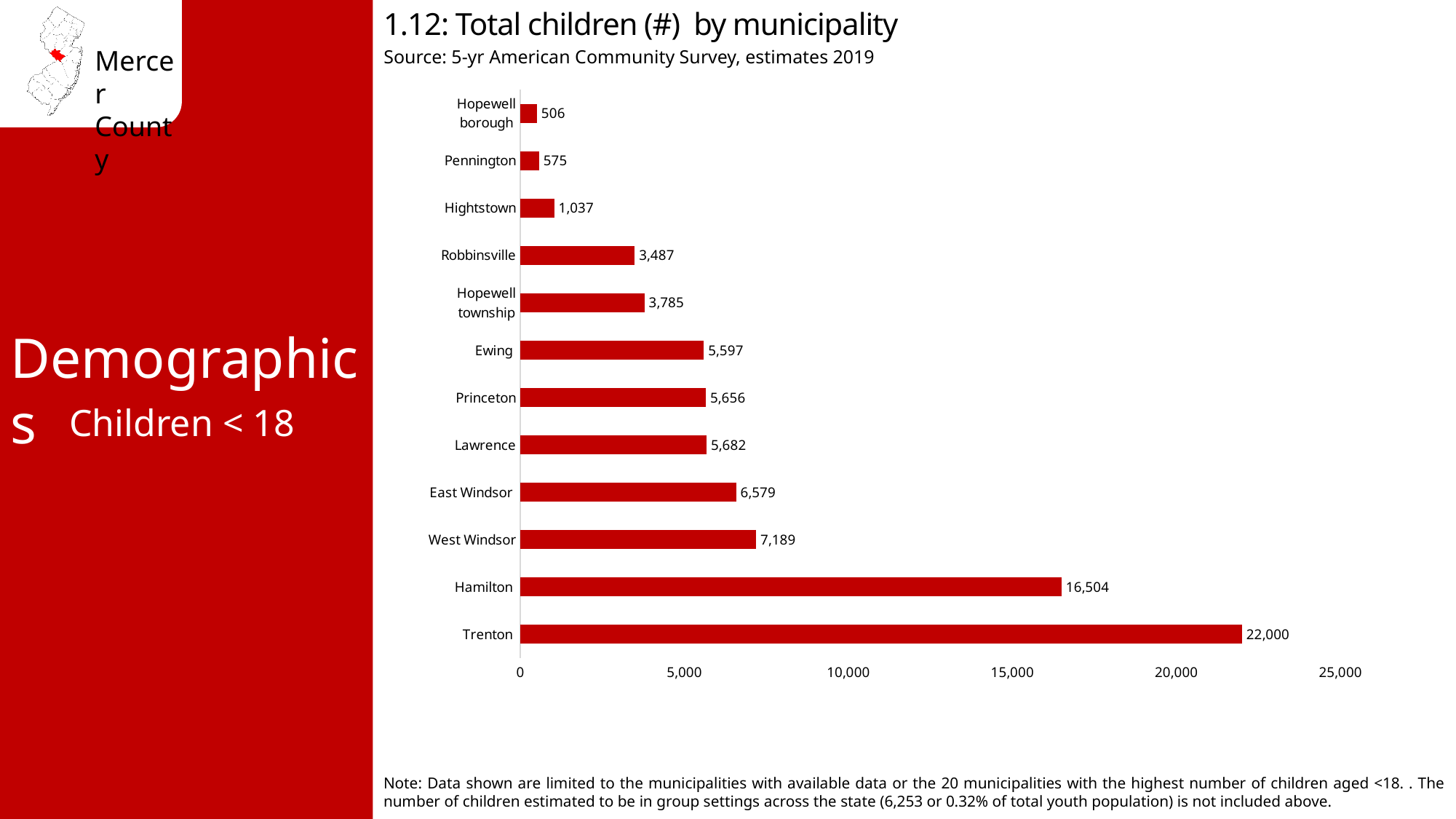
What kind of chart is used to show total children by municipality? bar chart How many municipalities are shown in the chart? 12 Is the value for Hamilton greater or less than 15,000? greater What is the difference in the number of children between Trenton and Hamilton? 5,496 What is the total number of children in East Windsor? 6,579 What is the total number of children in Trenton? 22,000 What is the total number of children in Hopewell township? 3,785 Which has more children, Robbinsville or Hopewell township? Hopewell township Which municipality has the highest number of children? Trenton What is the source of the data shown in the chart? 5-yr American Community Survey, estimates 2019 Which municipality has the lowest number of children? Hopewell borough What is the difference in the number of children between West Windsor and East Windsor? 610